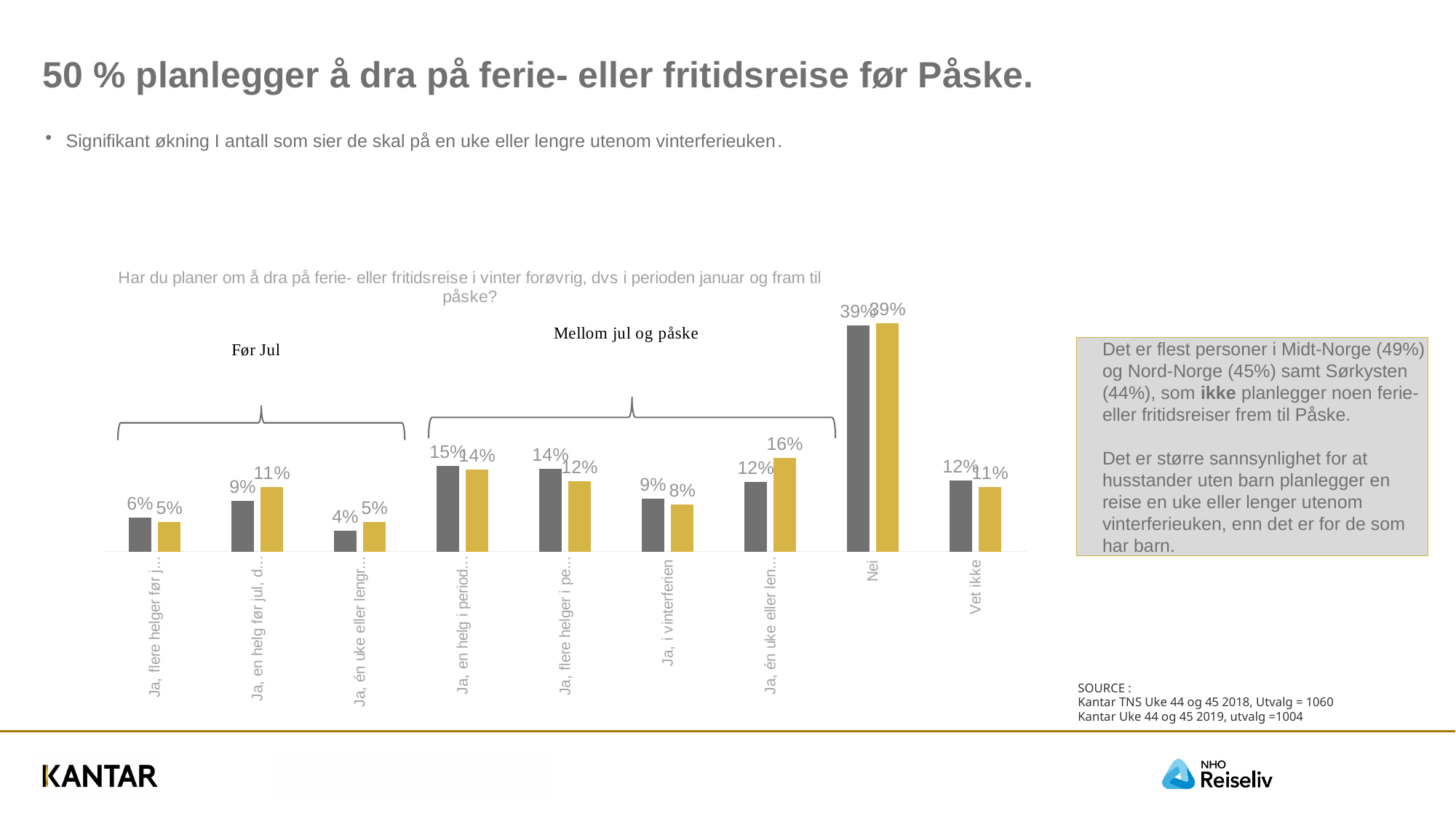
What is the value of the grey bar for the category "Ja, i vinterferien"? 9% How many categories are shown along the x axis of the chart? 9 What kind of chart is shown on the slide? bar chart What is the difference between the grey bar and the gold bar for "Ja, i vinterferien"? 1% Which category has the highest values in the chart? Nei What is the value of the gold bar for the category "Ja, i vinterferien"? 8% For the category "Vet ikke", which bar is larger, the grey bar or the gold bar? the grey bar What is the value of the grey bar for the category "Nei"? 39% What is the value of the gold bar for the category "Vet ikke"? 11% What is the value of the grey bar for the category "Vet ikke"? 12% What is the value of the gold bar for the category "Nei"? 39% What is the title of the chart? Har du planer om å dra på ferie- eller fritidsreise i vinter forøvrig, dvs i perioden januar og fram til påske?